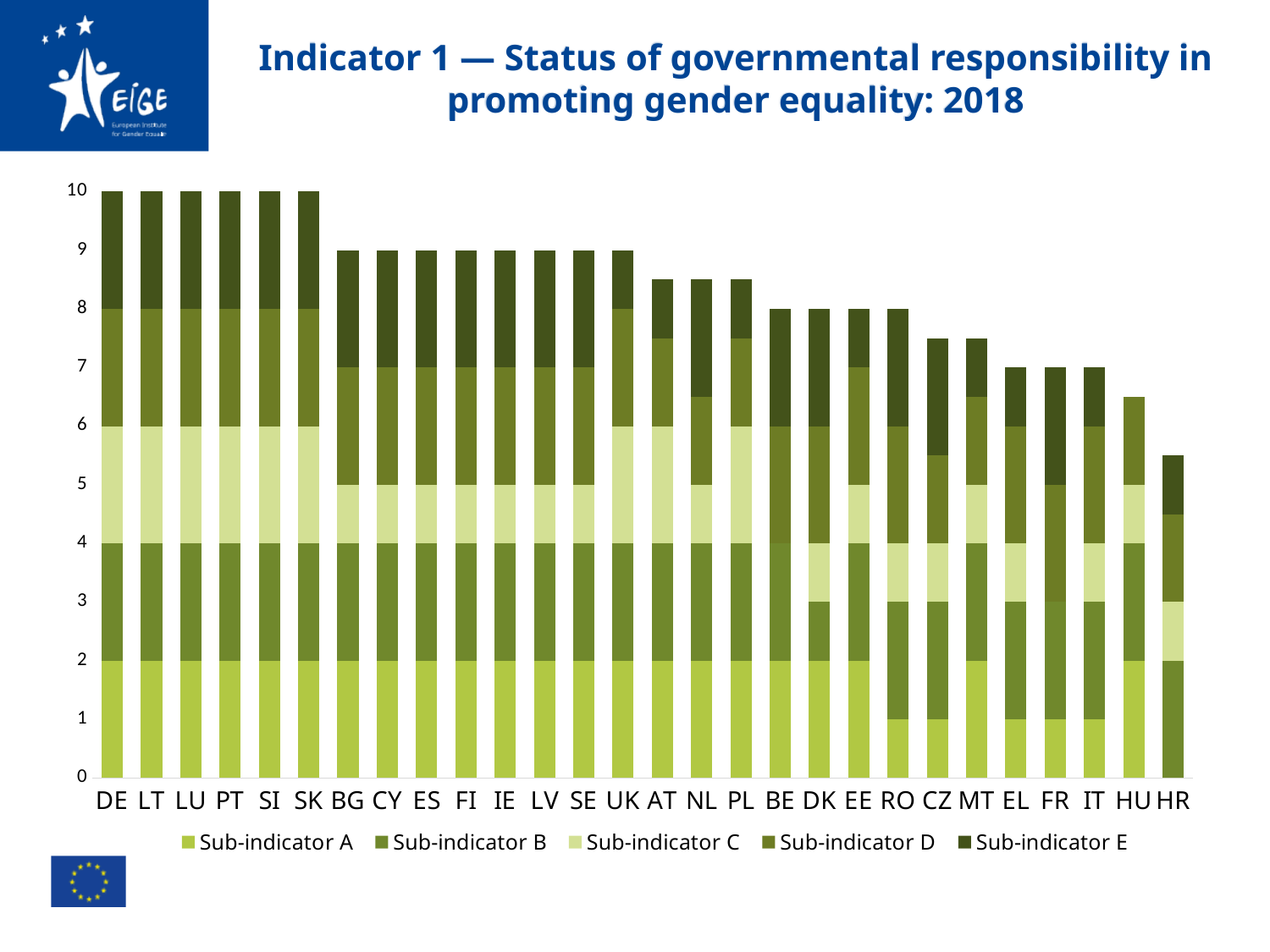
What is the total stacked value for BG? 9 How many series does the legend list? 5 What is the total stacked value for BE? 8 Is the total value for HU greater or less than 6? greater Which country has the lowest total score? HR How many countries are shown along the x axis? 28 What kind of chart is shown on the slide? stacked bar chart Is the total value for HR greater or less than 6? less Which has a larger total score, SK or HR? SK What is the total stacked value for EL? 7 What is the name of the last series listed in the legend? Sub-indicator E